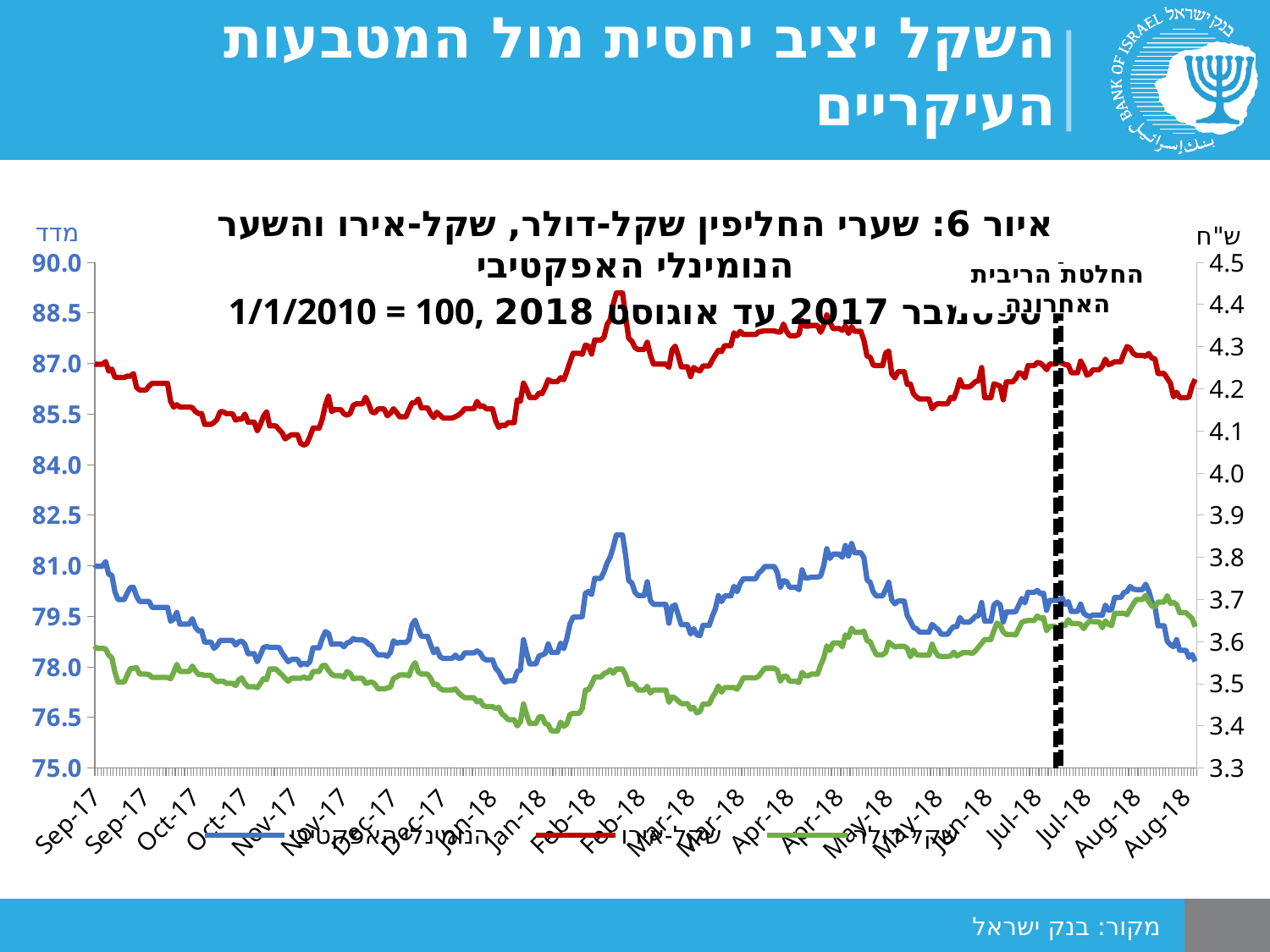
What kind of chart is shown on the slide? line chart Is the peak value of the שקל-אירו (red) line in Feb-18 greater or less than 4.4? greater What does the dashed vertical line near Jul-18 mark, according to its label? החלטת הריבית האחרונה Is the lowest value of the שקל-אירו (red) line around Nov-17 greater or less than 4.2? less Which series is plotted in red? שקל-אירו How many series does the legend list? 3 Does the השער הנומינלי האפקטיבי (blue) line overall rise or fall from Sep-17 to Aug-18? fall On the right-hand axis, which line is higher throughout the period: שקל-אירו or שקל-דולר? שקל-אירו Is the lowest value of the שקל-דולר (green) line around Feb-18 greater or less than 3.5? less